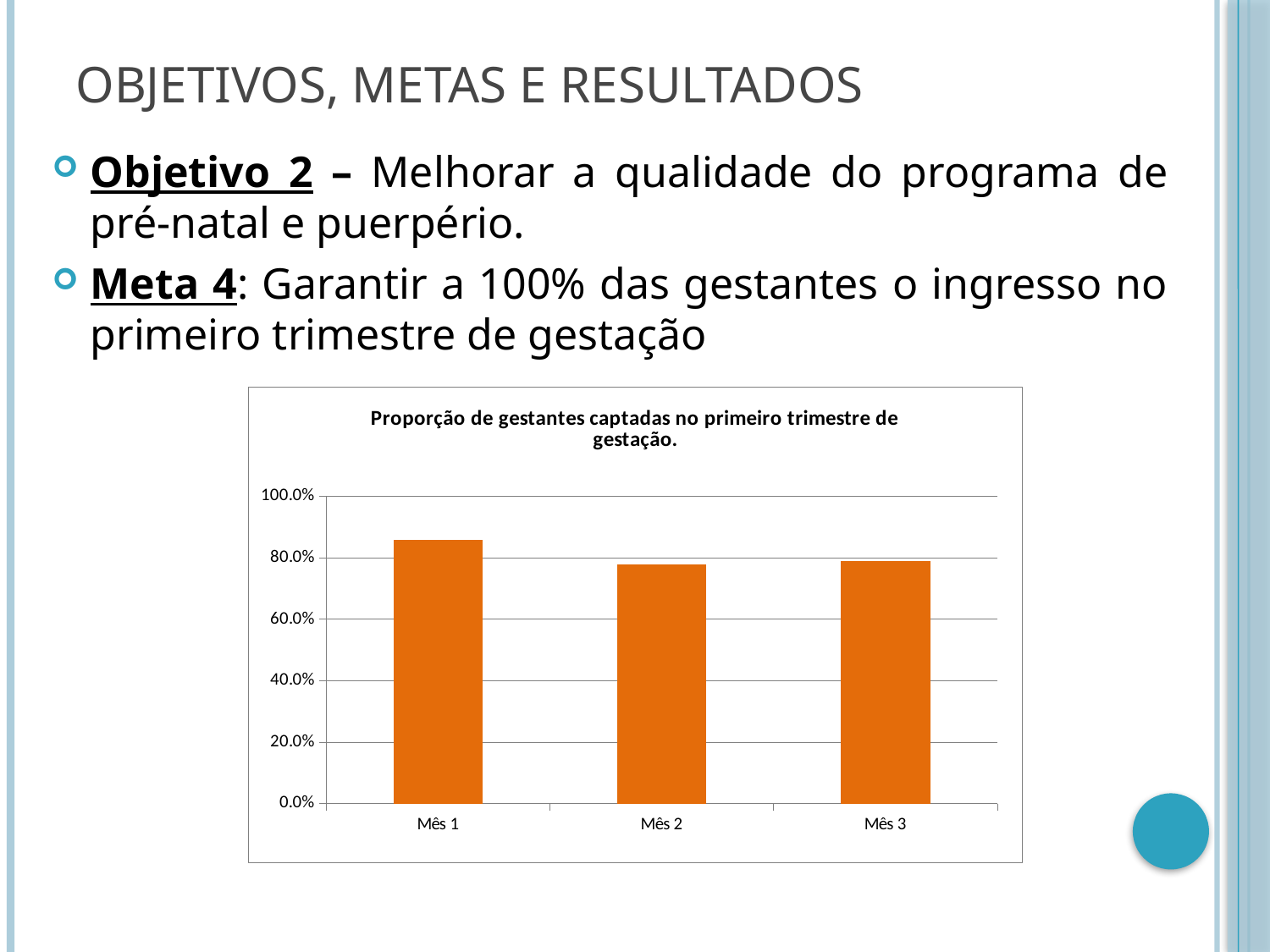
Which is larger, the value for Mês 1 or the value for Mês 3? Mês 1 Is the value for Mês 1 greater or less than 100.0%? less Which is larger, the value for Mês 1 or the value for Mês 2? Mês 1 What is the title of the chart? Proporção de gestantes captadas no primeiro trimestre de gestação. What colour are the bars in the chart? orange Which month has the highest proportion of pregnant women captured in the first trimester? Mês 1 What kind of chart is shown on the slide? bar chart What is the highest value shown on the vertical axis of the chart? 100.0% Is the value for Mês 1 greater or less than 80.0%? greater Is the value for Mês 3 greater or less than 60.0%? greater How many months (categories) are plotted in the chart? 3